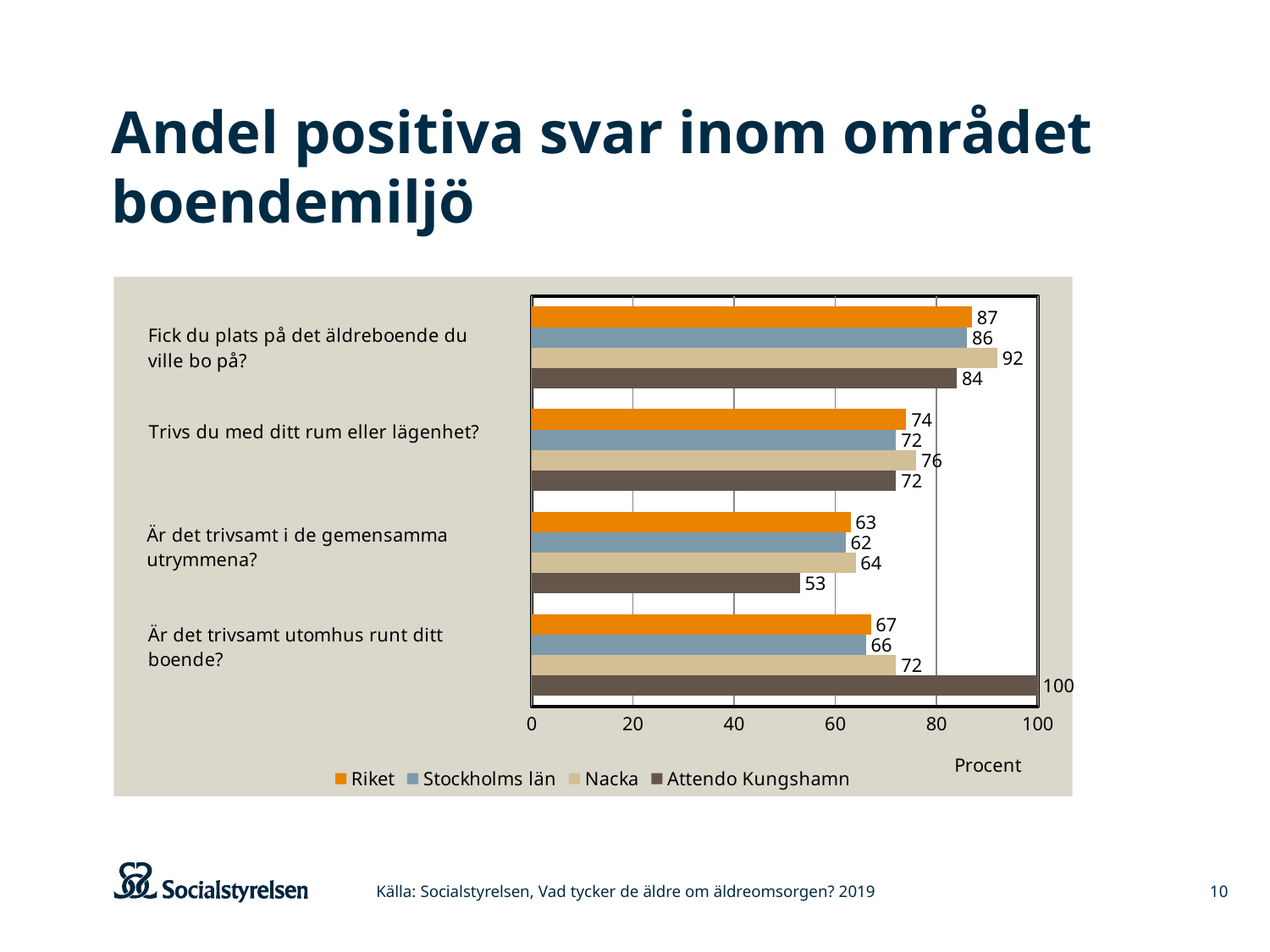
What is the value for Attendo Kungshamn on "Är det trivsamt utomhus runt ditt boende?"? 100 What is the value for Nacka on "Fick du plats på det äldreboende du ville bo på?"? 92 Which series has the highest value on "Fick du plats på det äldreboende du ville bo på?"? Nacka What is the value for Stockholms län on "Är det trivsamt i de gemensamma utrymmena?"? 62 Which series has the lowest value on "Är det trivsamt i de gemensamma utrymmena?"? Attendo Kungshamn What is the value for Riket on "Trivs du med ditt rum eller lägenhet?"? 74 How many series does the legend list? 4 What is the label of the horizontal axis? Procent Which is larger on "Är det trivsamt utomhus runt ditt boende?": Riket or Nacka? Nacka What kind of chart is shown on the slide? Bar chart What is the difference between Nacka and Attendo Kungshamn on "Är det trivsamt i de gemensamma utrymmena?"? 11 How many question categories are shown on the chart? 4